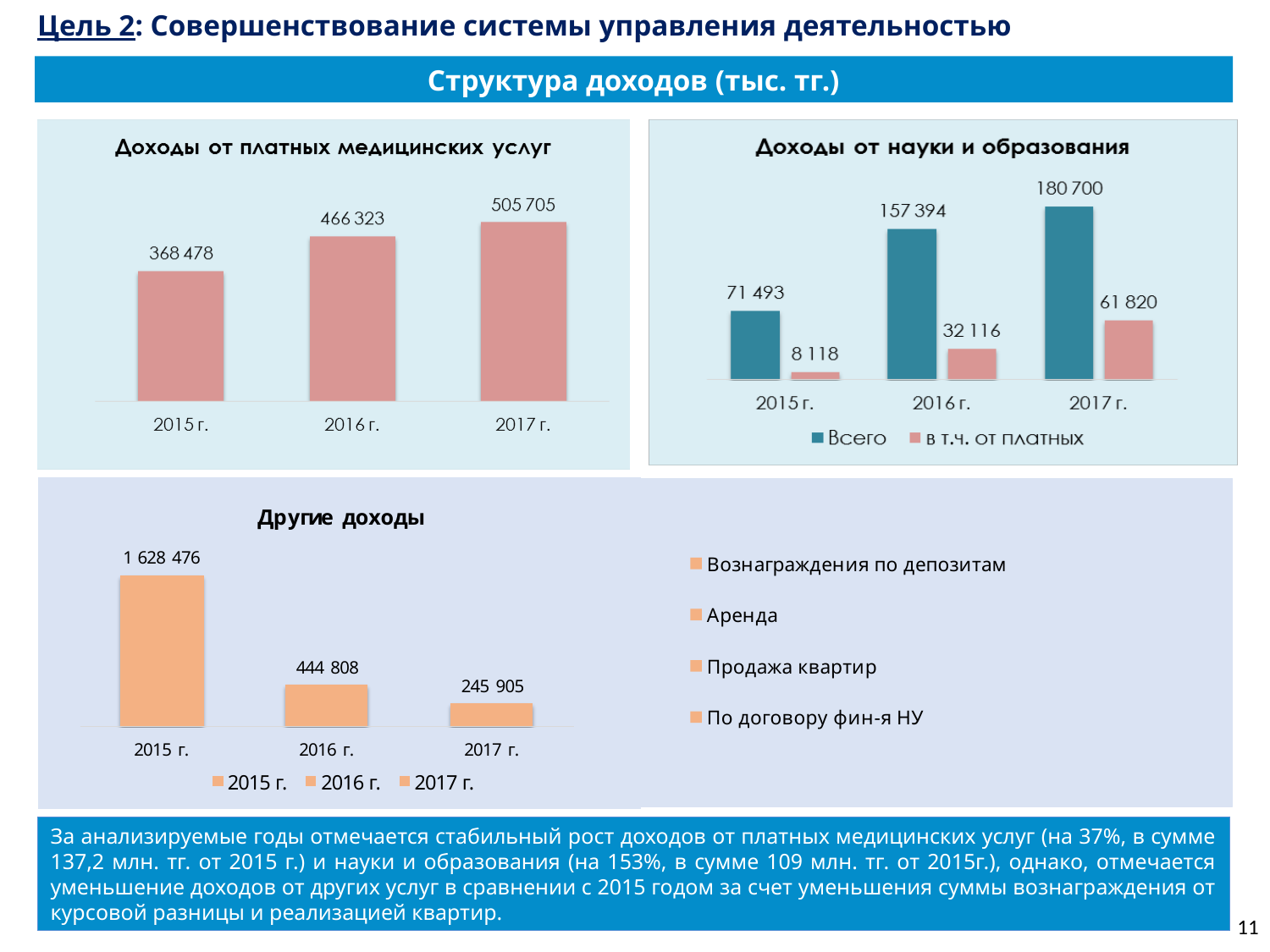
What type of chart is 'Другие доходы'? bar chart In the chart 'Другие доходы', what is the value for 2015 г.? 1 628 476 In the chart 'Доходы от науки и образования', what is the 'в т.ч. от платных' value for 2015 г.? 8 118 In the chart 'Доходы от науки и образования', what is the 'Всего' value for 2016 г.? 157 394 In the chart 'Доходы от науки и образования', how many series does the legend list? 2 In the chart 'Доходы от платных медицинских услуг', what is the value for 2016 г.? 466 323 In the chart 'Другие доходы', which year has the lowest value? 2017 г. In the chart 'Доходы от науки и образования', what is the difference between the 'в т.ч. от платных' values for 2017 г. and 2016 г.? 29 704 In the chart 'Доходы от науки и образования', which is larger: 'Всего' for 2015 г. or 'в т.ч. от платных' for 2017 г.? Всего for 2015 г. In the chart 'Доходы от платных медицинских услуг', which year has the highest value? 2017 г. In the chart 'Доходы от платных медицинских услуг', what is the difference between the 2017 г. and 2015 г. values? 137 227 In the chart 'Доходы от платных медицинских услуг', do the values rise or fall from 2015 г. to 2017 г.? rise